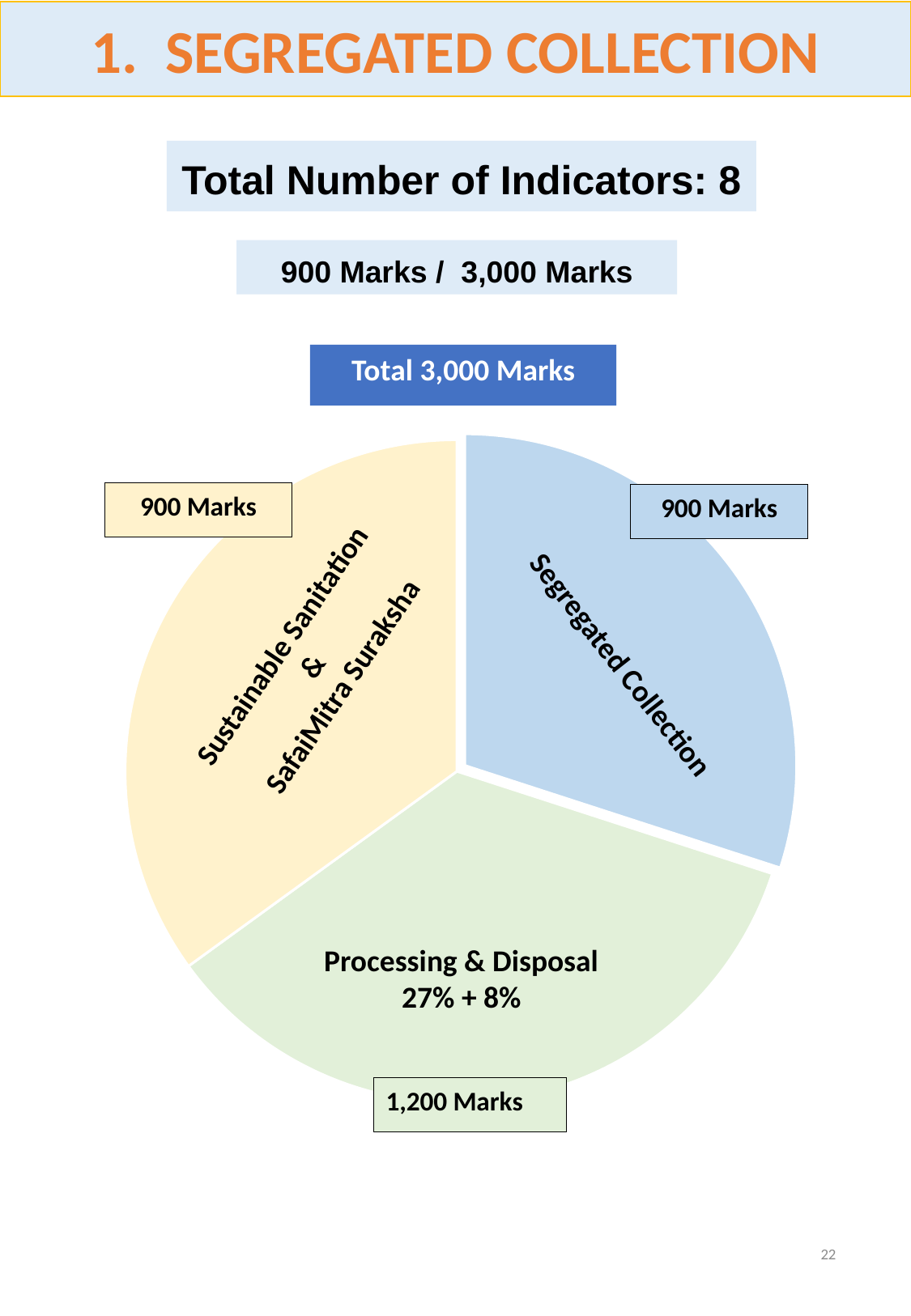
Which slice of the pie chart has the most marks? Processing & Disposal How many marks are allocated to Sustainable Sanitation & SafaiMitra Suraksha in the pie chart? 900 Marks What is the difference in marks between Processing & Disposal and Segregated Collection? 300 Marks Which has more marks, Processing & Disposal or Sustainable Sanitation & SafaiMitra Suraksha? Processing & Disposal Do Segregated Collection and Sustainable Sanitation & SafaiMitra Suraksha have the same number of marks? Yes What percentage text is printed inside the Processing & Disposal slice? 27% + 8% What is the total number of marks across all slices of the pie chart? 3,000 Marks What is the title shown in the blue box above the pie chart? Total 3,000 Marks What kind of chart is shown on the slide? pie chart How many slices does the pie chart have? 3 How many marks are allocated to Segregated Collection in the pie chart? 900 Marks How many marks are allocated to Processing & Disposal in the pie chart? 1,200 Marks